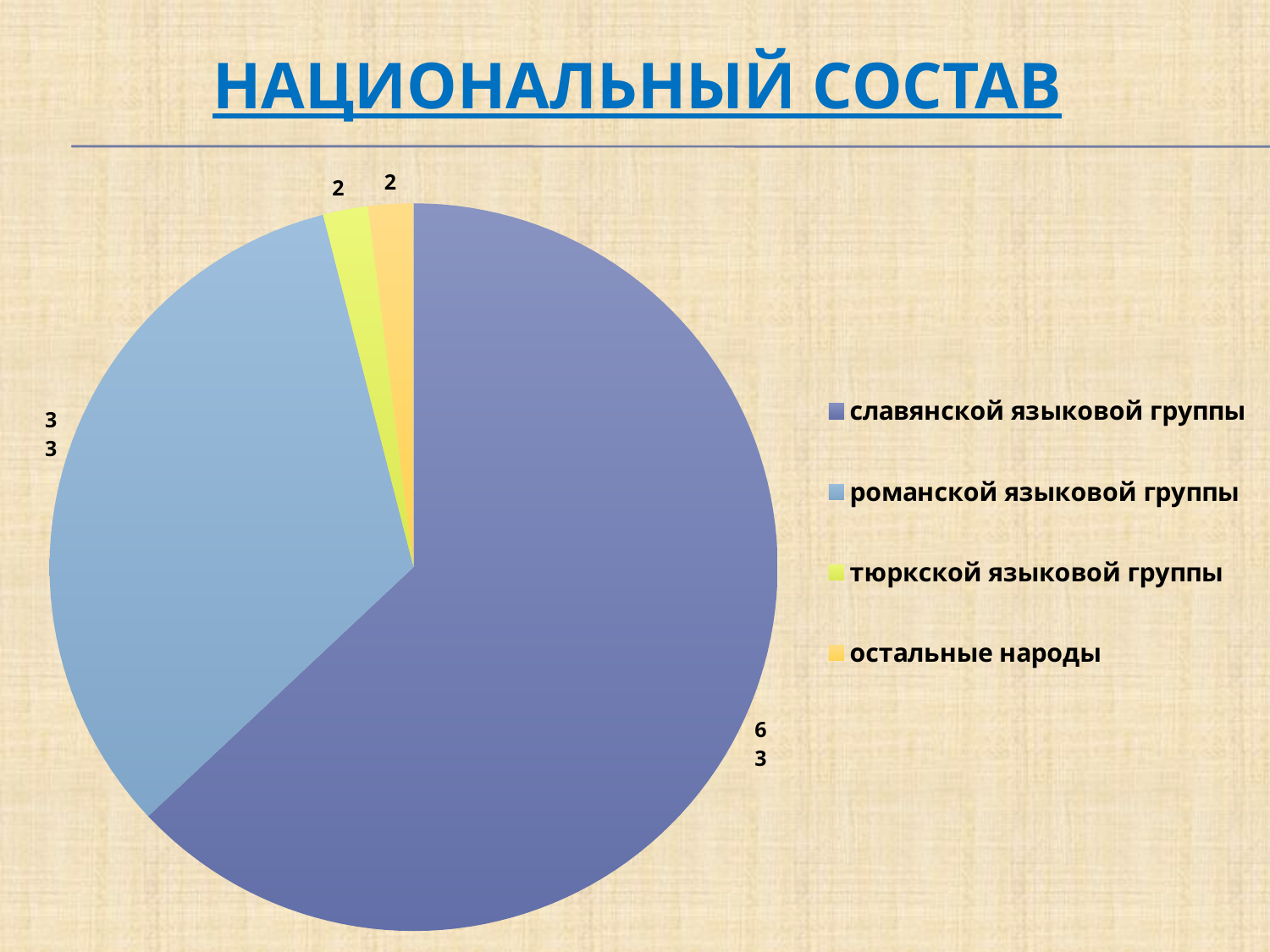
Which is larger, the value for романской языковой группы or the value for тюркской языковой группы? романской языковой группы How many entries does the legend list? 4 What is the title of the slide? НАЦИОНАЛЬНЫЙ СОСТАВ What share of the pie does славянской языковой группы represent? 63% Which category has the largest slice of the pie? славянской языковой группы What is the value for славянской языковой группы? 63 What is the value for тюркской языковой группы? 2 What is the difference between the values for славянской языковой группы and романской языковой группы? 30 How many slices does the pie chart have? 4 What is the value for остальные народы? 2 What kind of chart is shown on the slide? pie chart What is the value for романской языковой группы? 33